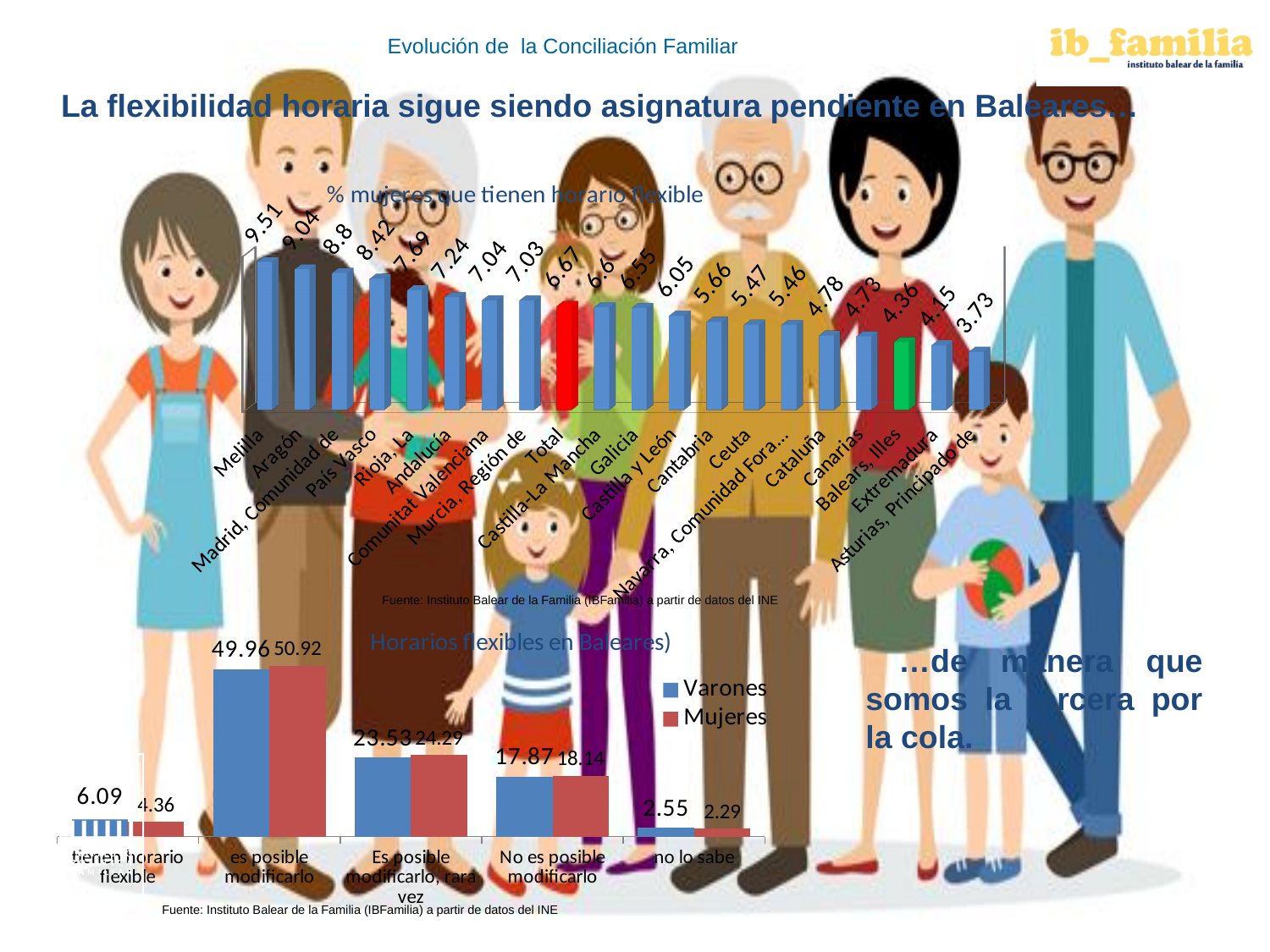
In the chart '% mujeres que tienen horario flexible', which category has the highest value? Melilla In the chart 'Horarios flexibles en Baleares', what is the Varones value for 'tienen horario flexible'? 6.09 In the chart '% mujeres que tienen horario flexible', what is the value for Balears, Illes? 4.36 In the chart '% mujeres que tienen horario flexible', what is the value for Melilla? 9.51 What kind of chart is 'Horarios flexibles en Baleares'? bar chart In the chart 'Horarios flexibles en Baleares', how many series does the legend list? 2 In the chart '% mujeres que tienen horario flexible', do the values rise or fall from left to right? fall In the chart '% mujeres que tienen horario flexible', which category has the lowest value? Asturias, Principado de In the chart 'Horarios flexibles en Baleares', what is the difference between the Varones and Mujeres values for 'No es posible modificarlo'? 0.27 In the chart '% mujeres que tienen horario flexible', how many categories are plotted? 20 In the chart 'Horarios flexibles en Baleares', what is the Mujeres value for 'es posible modificarlo'? 50.92 In the chart '% mujeres que tienen horario flexible', what is the value for Total? 6.67